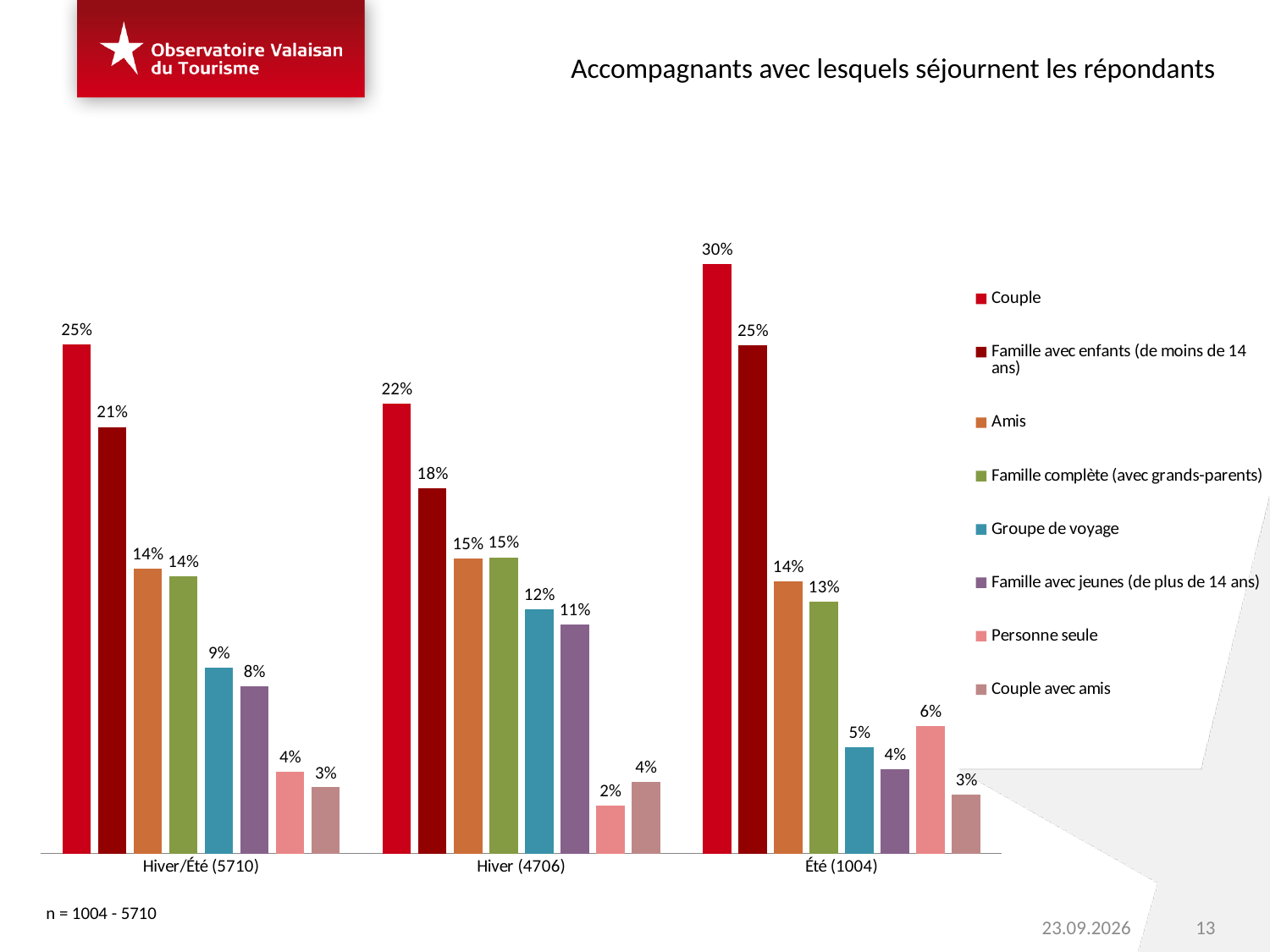
Which is larger in the Hiver/Été (5710) category: Groupe de voyage or Famille avec jeunes (de plus de 14 ans)? Groupe de voyage How many categories are shown on the x axis? 3 Which series has the lowest value in the Hiver (4706) category? Personne seule What is the value for Couple in the Été (1004) category? 30% Which series has the highest value in the Hiver (4706) category? Couple What is the title of the chart? Accompagnants avec lesquels séjournent les répondants What is the difference between Couple and Famille avec enfants (de moins de 14 ans) in the Été (1004) category? 5% What is the value for Groupe de voyage in the Hiver (4706) category? 12% How many series does the legend list? 8 How does the value for Couple change from Hiver/Été (5710) to Hiver (4706) to Été (1004)? It falls then rises What is the value for Personne seule in the Hiver/Été (5710) category? 4% What kind of chart is shown on the slide? Bar chart